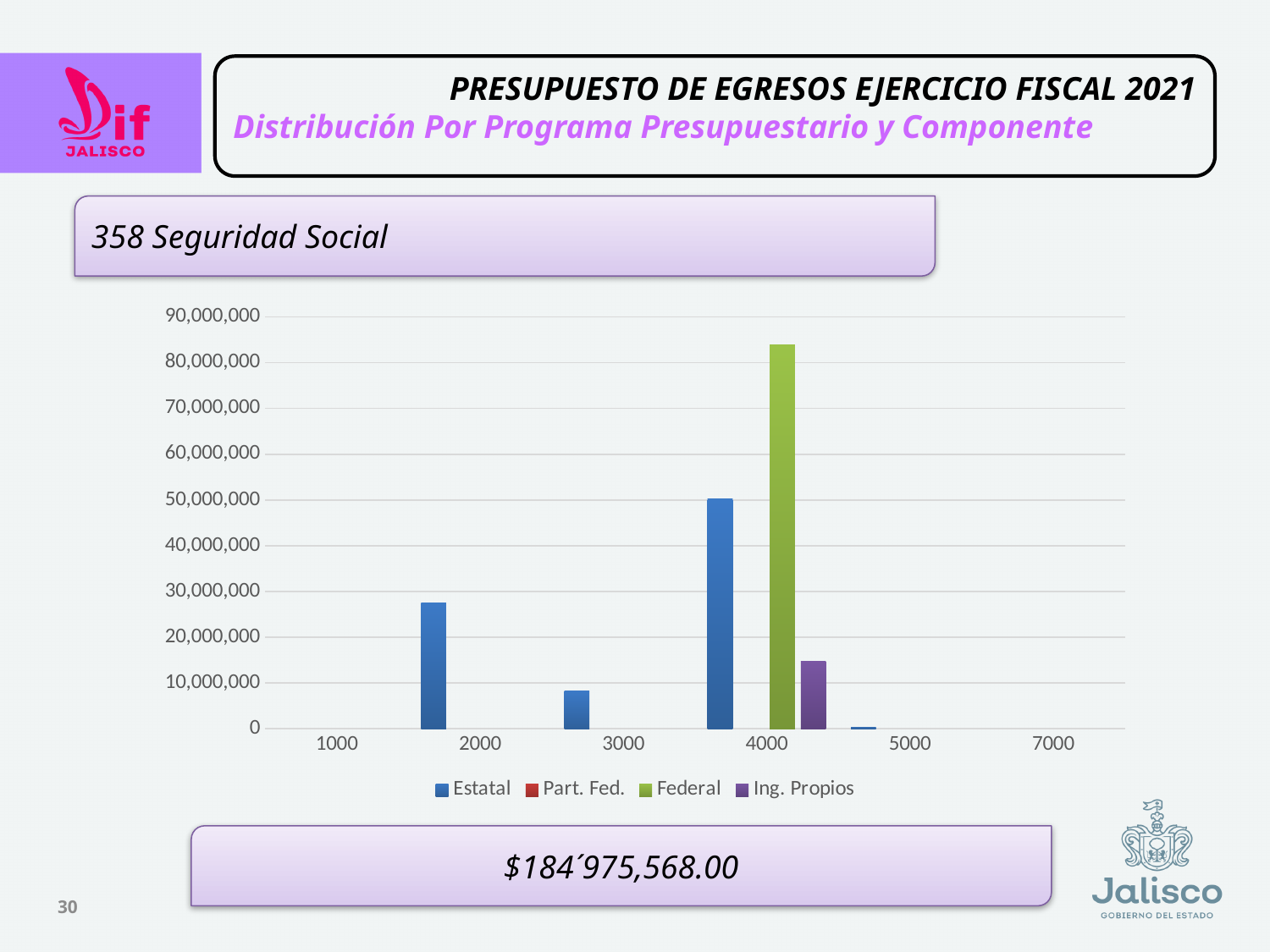
Is the Federal value for category 4000 greater or less than 80,000,000? greater For category 4000, which is larger: the Federal bar or the Estatal bar? Federal Is the Ing. Propios value for category 4000 greater or less than 10,000,000? greater Which category has the tallest Estatal bar? 4000 What colour represents the Federal series in the legend? green What kind of chart is shown on the slide? bar chart How many categories are shown on the x axis? 6 Is the Estatal value for category 3000 greater or less than 10,000,000? less What is the title of the program shown above the chart? 358 Seguridad Social How many series does the legend list? 4